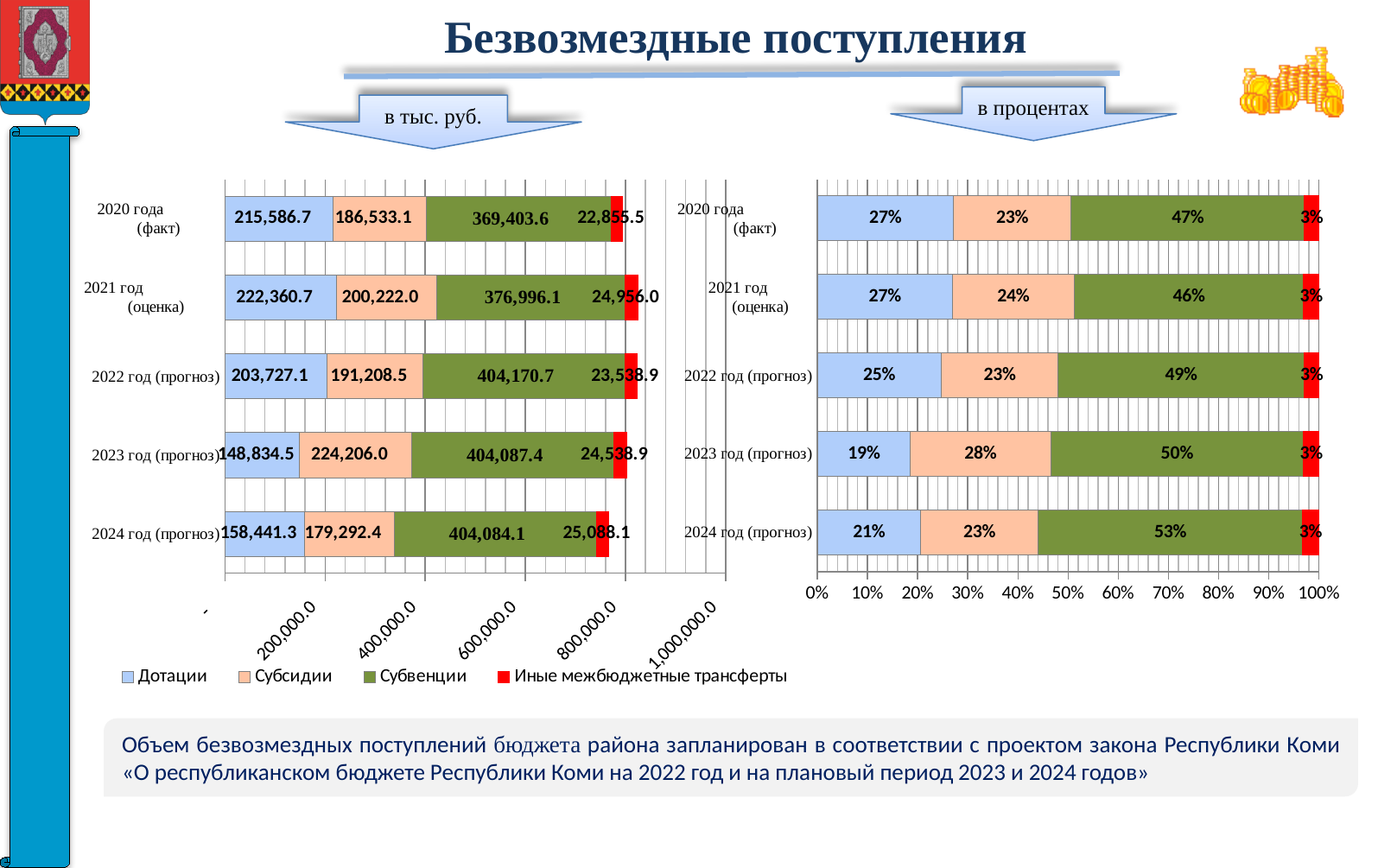
In the right chart (в процентах), what is the share of Субсидии for 2023 год (прогноз)? 28% What kind of chart is the left chart (в тыс. руб.)? Stacked bar chart In the left chart (в тыс. руб.), what is the value of Субвенции for 2022 год (прогноз)? 404,170.7 In the left chart (в тыс. руб.), what is the value of Иные межбюджетные трансферты for 2024 год (прогноз)? 25,088.1 In the right chart (в процентах), which year has the lowest share of Дотации? 2023 год (прогноз) In the left chart (в тыс. руб.), which year has the lowest value for Дотации? 2023 год (прогноз) In the left chart (в тыс. руб.), which year has the highest value for Дотации? 2021 год (оценка) How many series does the legend list? 4 In the right chart (в процентах), what is the share of Субвенции for 2024 год (прогноз)? 53% In the left chart (в тыс. руб.), what is the total of the stacked bar for 2020 года (факт)? 794,378.9 In the left chart (в тыс. руб.), what is the value of Дотации for 2020 года (факт)? 215,586.7 In the left chart (в тыс. руб.), what is the difference between the Дотации values for 2021 год (оценка) and 2020 года (факт)? 6,774.0